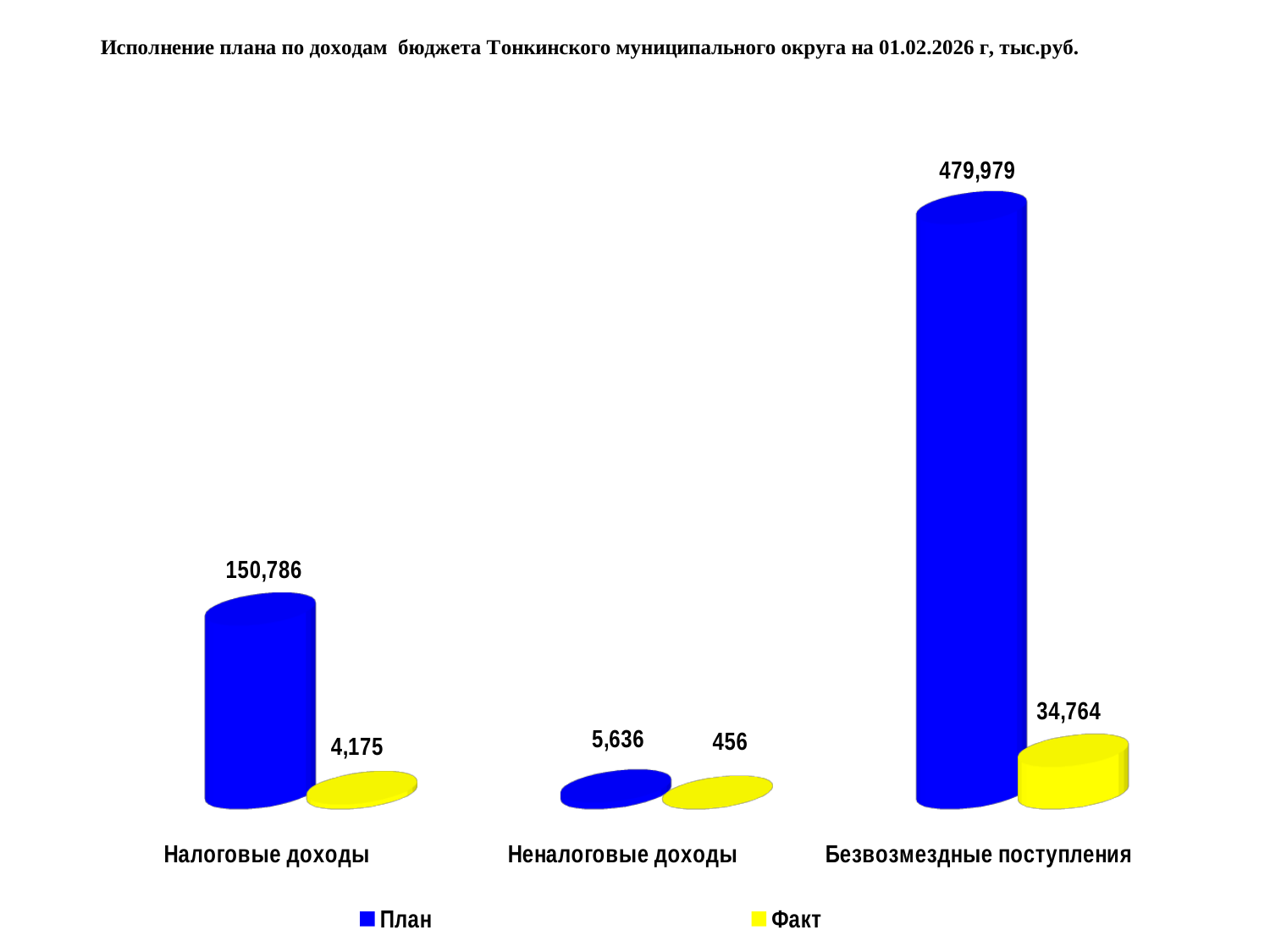
What is the Факт value for Неналоговые доходы? 456 Which category has the highest План value? Безвозмездные поступления How many series does the legend list? 2 What is the difference between the План and Факт values for Налоговые доходы? 146,611 What is the difference between the План and Факт values for Безвозмездные поступления? 445,215 What is the План value for Неналоговые доходы? 5,636 Which is larger: the Факт value for Налоговые доходы or the Факт value for Безвозмездные поступления? Безвозмездные поступления How many categories are shown on the x axis? 3 Which category has the lowest Факт value? Неналоговые доходы What is the План value for Налоговые доходы? 150,786 What kind of chart is shown on the slide? Bar chart What is the Факт value for Безвозмездные поступления? 34,764